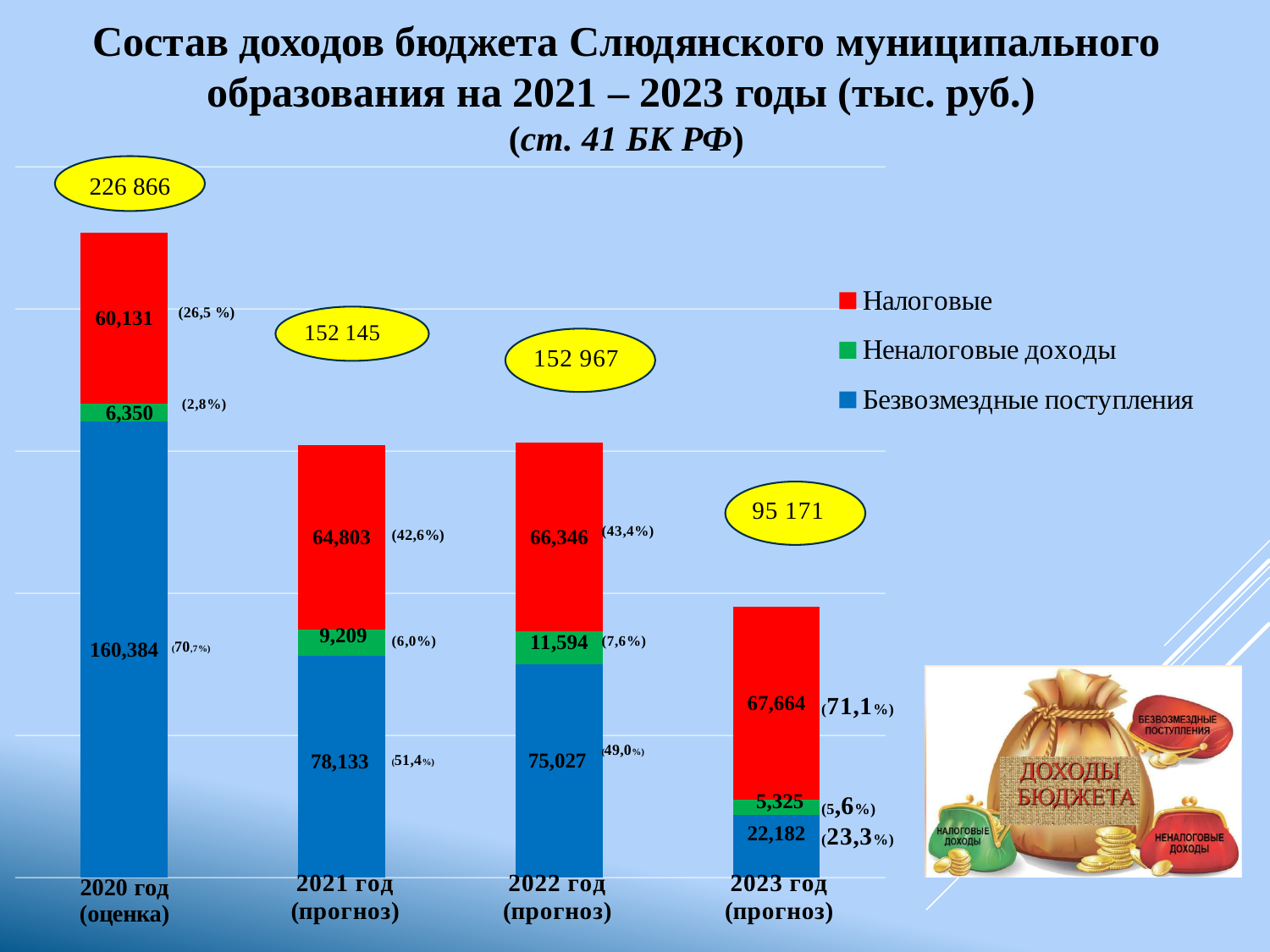
What is the value of Налоговые for 2021 год (прогноз)? 64,803 In which year is the Неналоговые доходы value the lowest? 2023 год (прогноз) In which year is the Налоговые value the highest? 2023 год (прогноз) What is the total shown for 2023 год (прогноз)? 95 171 How many series does the legend list? 3 What is the difference between the Безвозмездные поступления values for 2020 год and 2021 год? 82,251 How many year categories are shown on the x axis? 4 What is the value of Неналоговые доходы for 2022 год (прогноз)? 11,594 What type of chart is shown on the slide? stacked bar chart Which year has the larger Безвозмездные поступления value, 2021 год or 2022 год? 2021 год (прогноз) What is the value of Безвозмездные поступления for 2020 год (оценка)? 160,384 Do the Налоговые values rise or fall from 2020 to 2023? rise